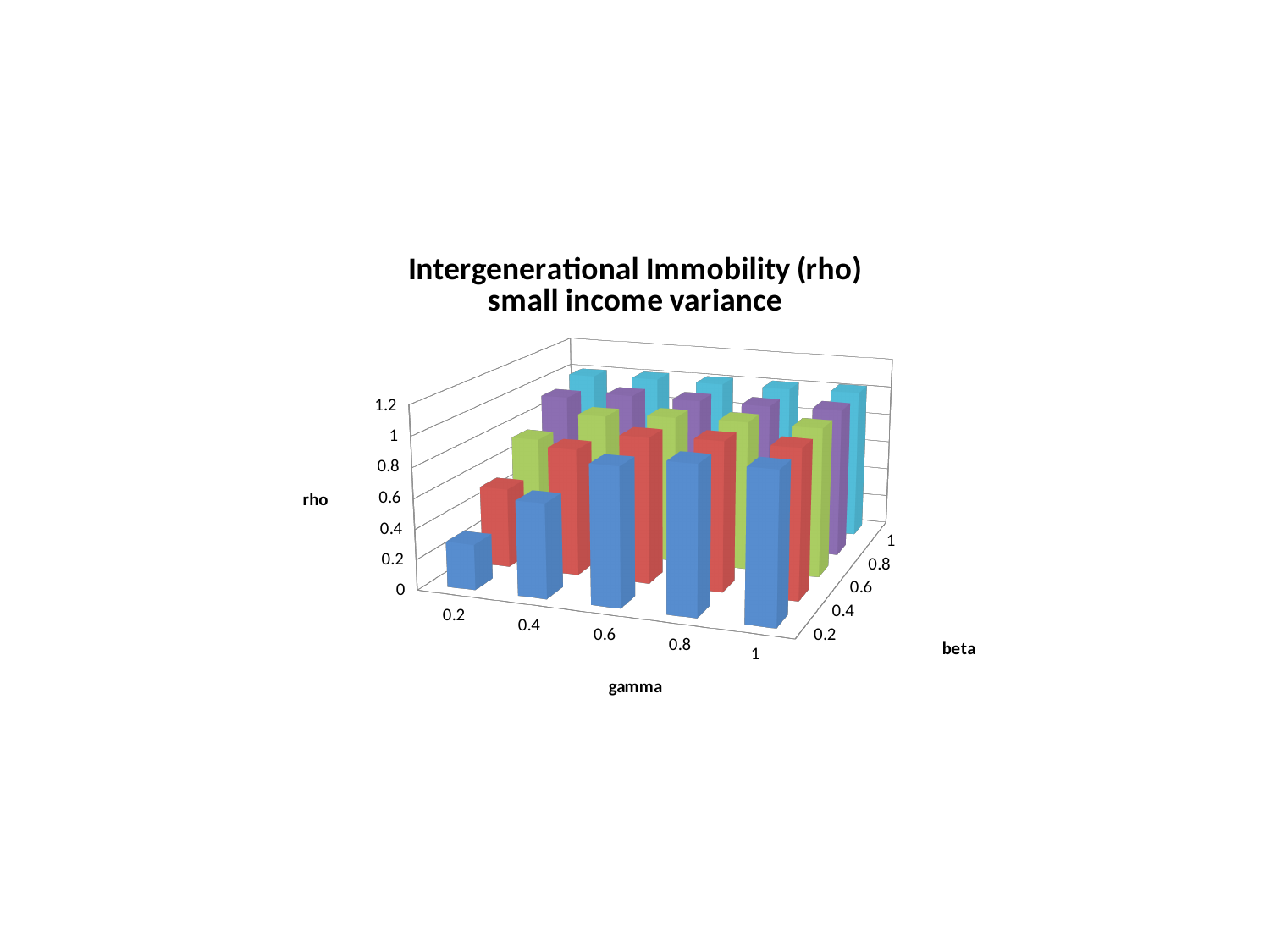
Is the rho value for gamma = 1 and beta = 0.2 greater or less than 0.4? greater How many gamma values are plotted along the gamma axis? 5 Is the rho value for gamma = 0.2 and beta = 0.2 greater or less than 0.6? less For beta = 0.2, which has the larger rho: gamma = 0.2 or gamma = 1? gamma = 1 For gamma = 0.2, do the rho values rise or fall as beta increases from 0.2 to 1? rise How many beta values are plotted along the beta axis? 5 What variable is plotted on the vertical axis? rho Among the bars for beta = 0.2, which gamma value has the lowest rho? 0.2 What kind of chart is shown on the slide? 3D bar chart What is the highest tick value shown on the rho axis? 1.2 For beta = 0.2, do the rho values rise or fall as gamma increases from 0.2 to 1? rise What is the title of the chart? Intergenerational Immobility (rho) small income variance